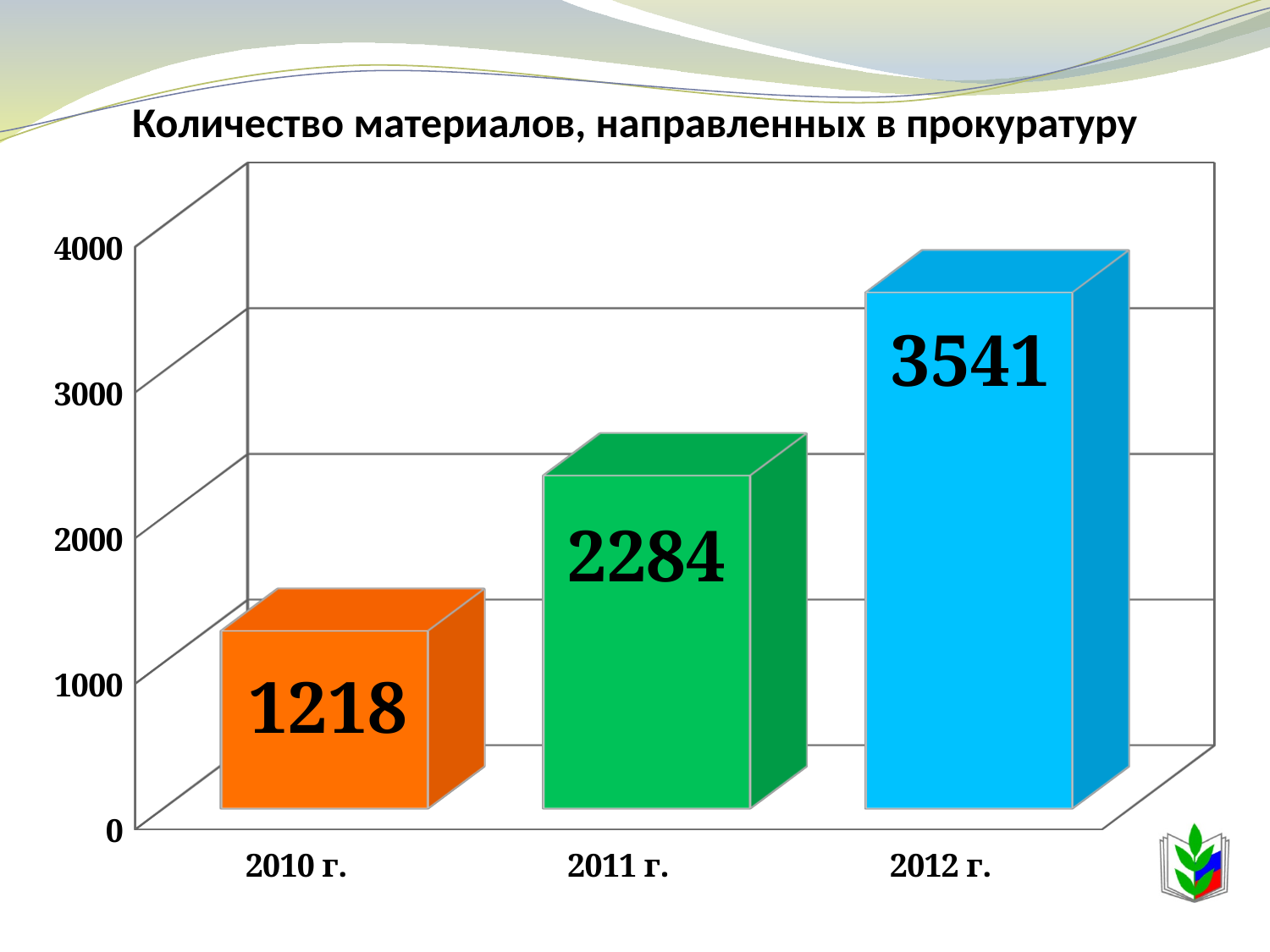
Which year has the lowest value? 2010 г. What is the difference between the values for 2011 г. and 2010 г.? 1066 Is the value for 2012 г. greater or less than 3000? greater Do the values rise or fall from 2010 г. to 2012 г.? rise What is the value for 2012 г.? 3541 Which year has the highest value? 2012 г. What is the difference between the values for 2012 г. and 2011 г.? 1257 What is the value for 2010 г.? 1218 What kind of chart is shown on the slide? bar chart Which is larger, the value for 2010 г. or the value for 2011 г.? 2011 г. How many years are shown on the chart? 3 What is the value for 2011 г.? 2284